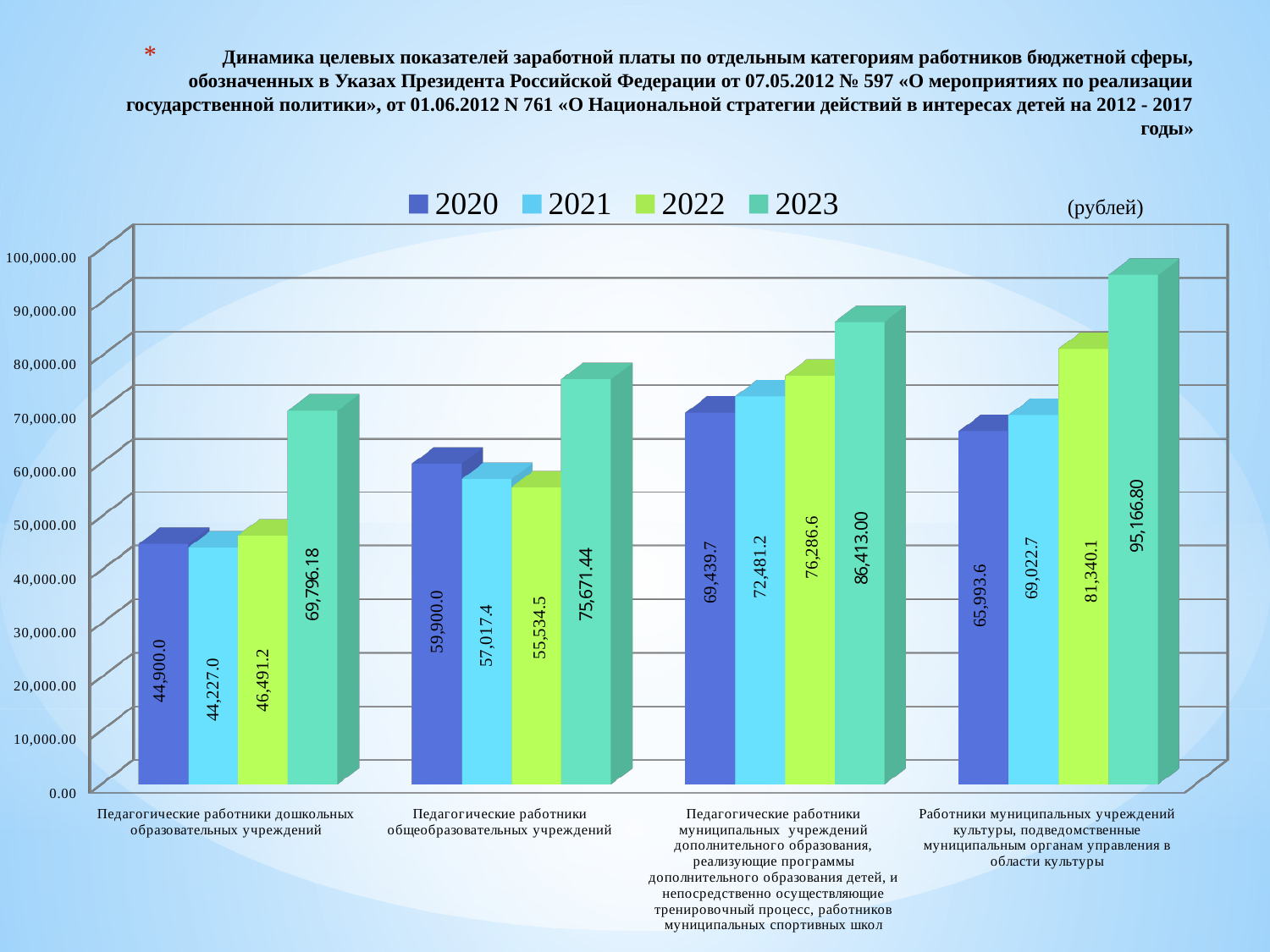
Which category has the highest 2023 value? Работники муниципальных учреждений культуры, подведомственные муниципальным органам управления в области культуры What is the 2023 value for Работники муниципальных учреждений культуры, подведомственные муниципальным органам управления в области культуры? 95,166.80 How many series does the legend list? 4 Do the values for Педагогические работники муниципальных учреждений дополнительного образования rise or fall from 2020 to 2023? Rise What is the 2021 value for Педагогические работники общеобразовательных учреждений? 57,017.4 What is the 2020 value for Педагогические работники дошкольных образовательных учреждений? 44,900.0 Which category has the lowest 2021 value? Педагогические работники дошкольных образовательных учреждений What kind of chart is shown on the slide? Bar chart What is the 2022 value for Педагогические работники муниципальных учреждений дополнительного образования? 76,286.6 What is the difference between the 2023 and 2022 values for Работники муниципальных учреждений культуры? 13,826.70 Which is larger for Педагогические работники общеобразовательных учреждений: the 2020 value or the 2022 value? 2020 How many categories are shown on the x axis? 4